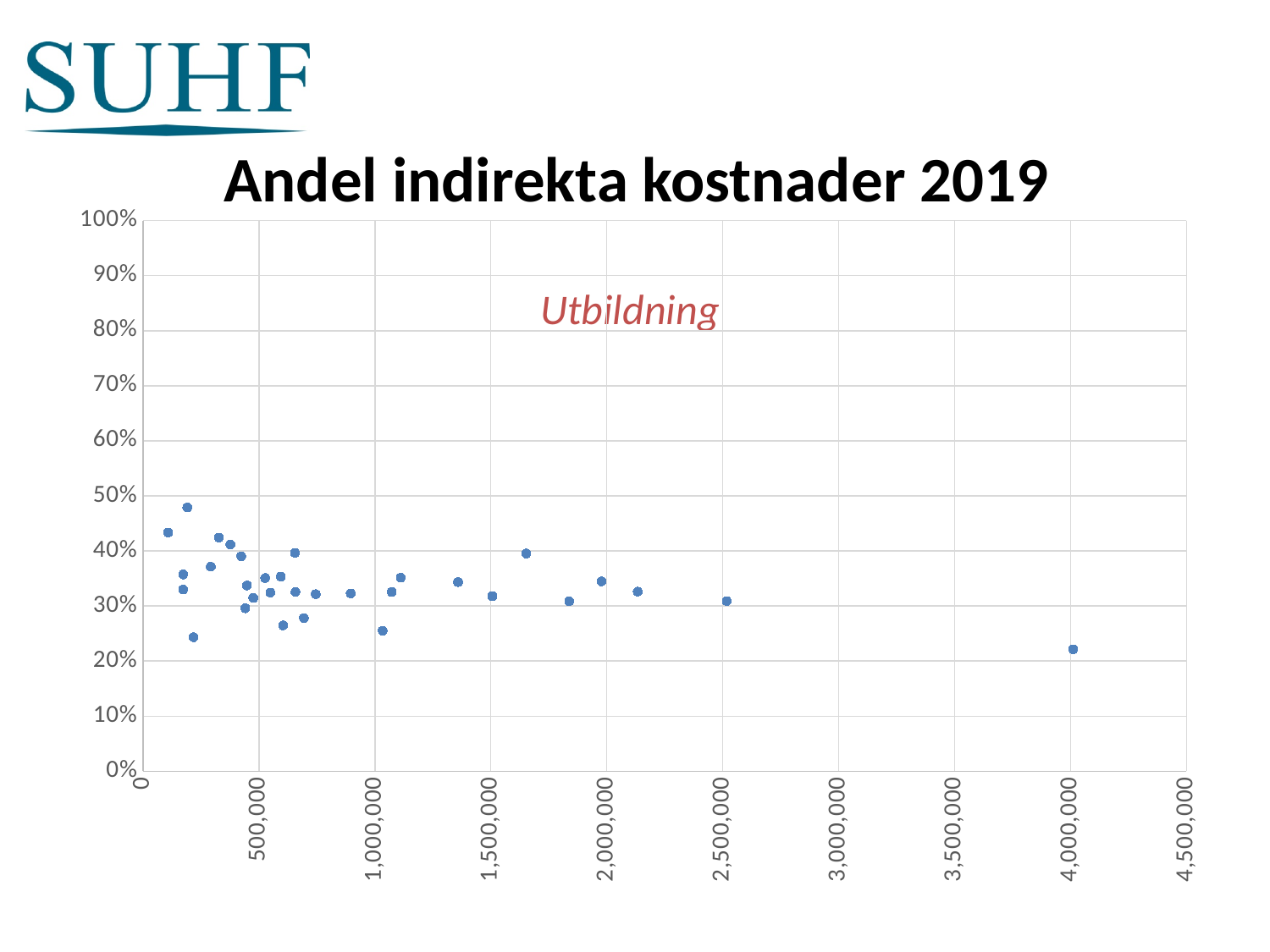
How many points lie above 50% on the y axis? 0 Is the point near 2,500,000 on the x axis greater or less than 40%? less Is the highest point on the chart greater or less than 40%? greater Is the lowest point on the chart greater or less than 25%? less How many points have an x value greater than 3,000,000? 1 Which is higher: the rightmost point (near 4,000,000) or the point near 2,500,000 on the x axis? the point near 2,500,000 What word is written in red italics inside the plot area? Utbildning What kind of chart is shown on the slide? scatter chart What is the title of the chart? Andel indirekta kostnader 2019